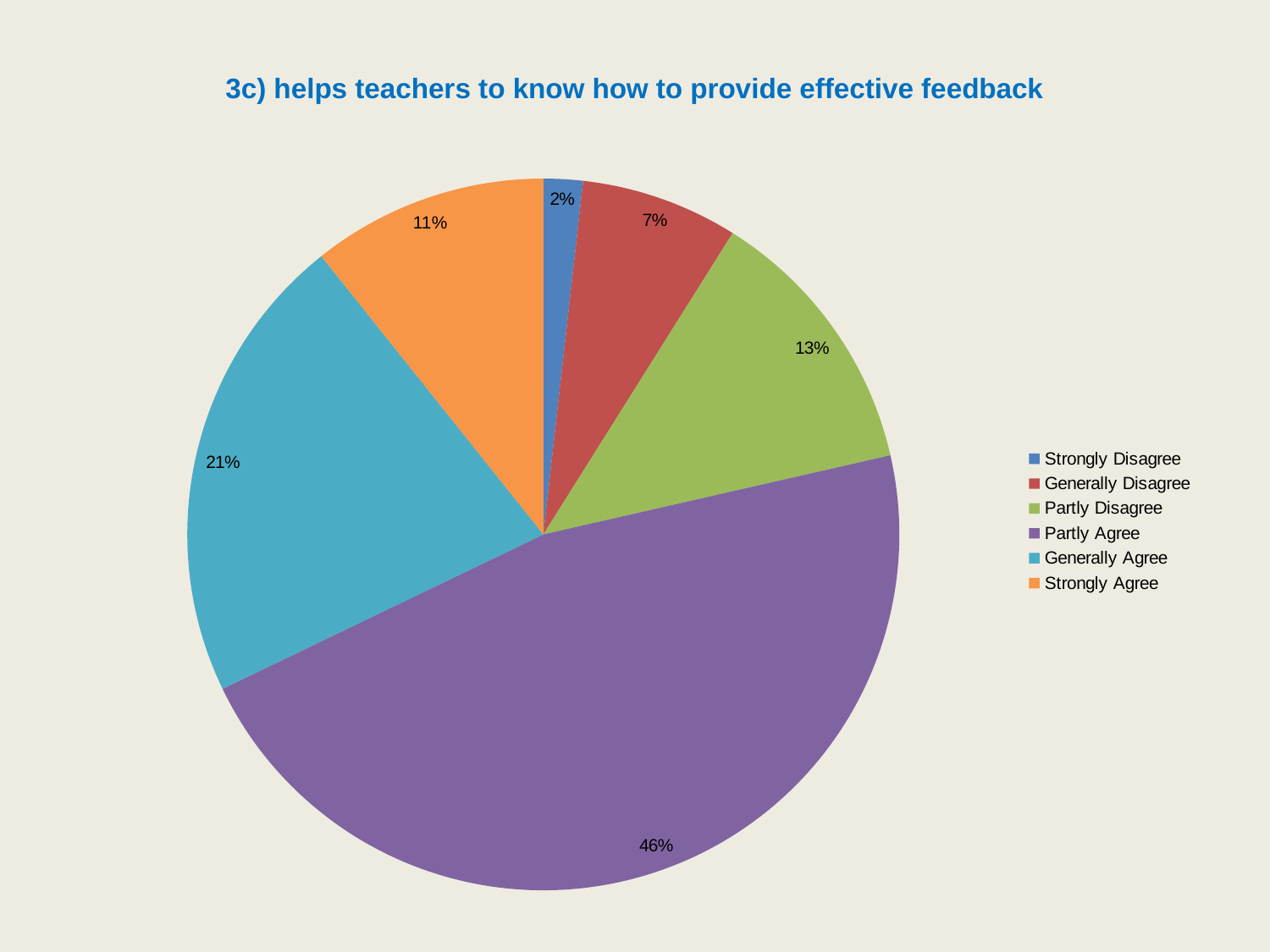
What percentage of respondents chose Strongly Disagree? 2% What type of chart is shown on the slide? pie chart What percentage of respondents chose Partly Agree? 46% How many categories does the legend list? 6 What percentage of respondents chose Strongly Agree? 11% What is the difference in percentage points between Partly Agree and Generally Agree? 25 Which is larger, the share for Partly Disagree or the share for Generally Disagree? Partly Disagree Which response category has the largest share of the pie? Partly Agree What colour is the Generally Disagree slice? red What is the title of the chart? 3c) helps teachers to know how to provide effective feedback Which response category has the smallest share of the pie? Strongly Disagree What percentage of respondents chose Generally Agree? 21%